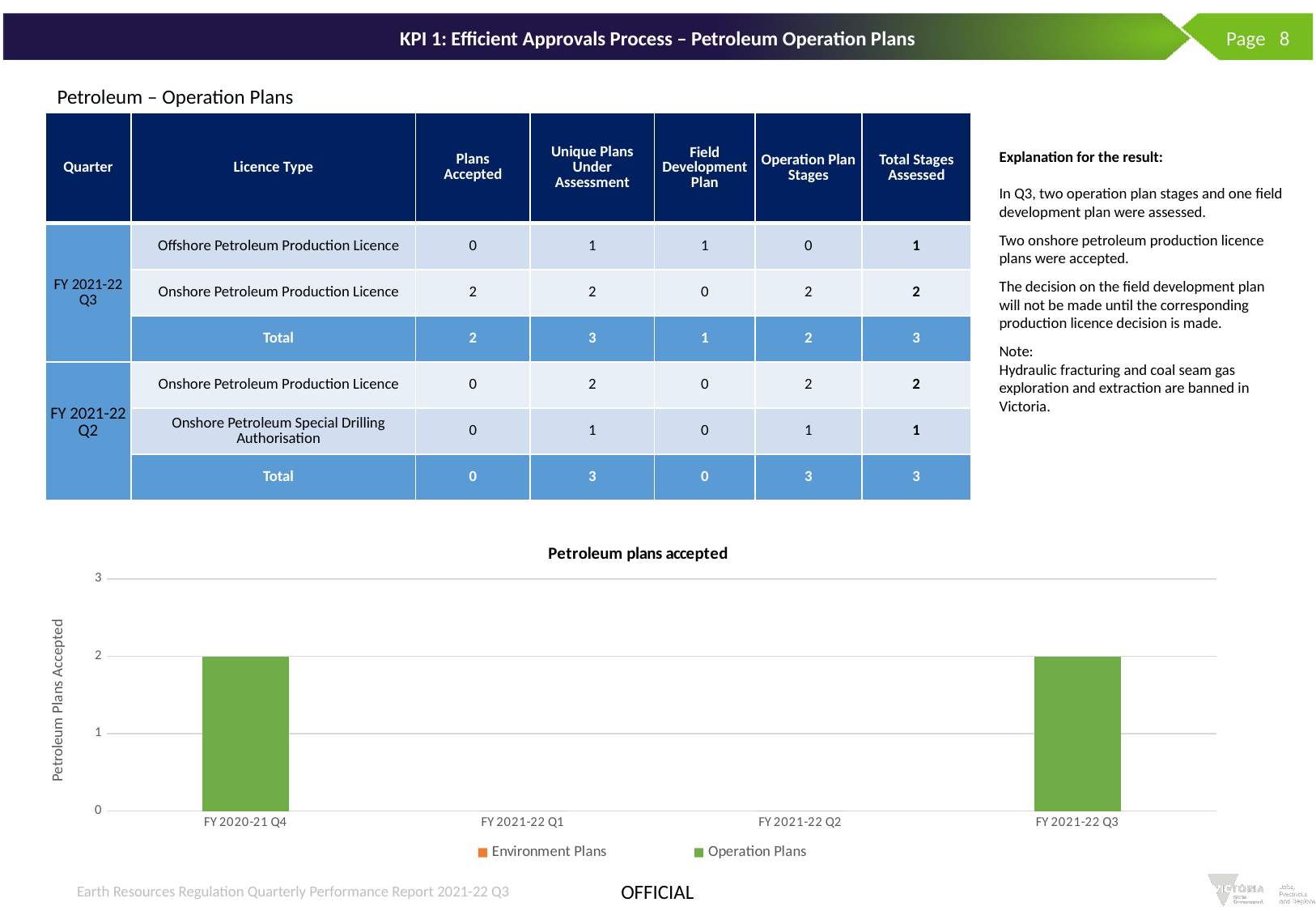
What kind of chart is shown on the slide? bar chart What is the value of Operation Plans for FY 2020-21 Q4 in the chart? 2 What is the title of the chart? Petroleum plans accepted How many quarters are shown on the x axis of the chart? 4 What is the difference between the Operation Plans values for FY 2020-21 Q4 and FY 2021-22 Q1? 2 What is the value of Operation Plans for FY 2021-22 Q1 in the chart? 0 Is the Operation Plans value for FY 2021-22 Q3 greater or less than 1? greater What is the value of Operation Plans for FY 2021-22 Q3 in the chart? 2 Which is larger in the chart: Operation Plans for FY 2021-22 Q2 or for FY 2021-22 Q3? FY 2021-22 Q3 What is the label of the y axis of the chart? Petroleum Plans Accepted How many series does the chart legend list? 2 What is the value of Operation Plans for FY 2021-22 Q2 in the chart? 0